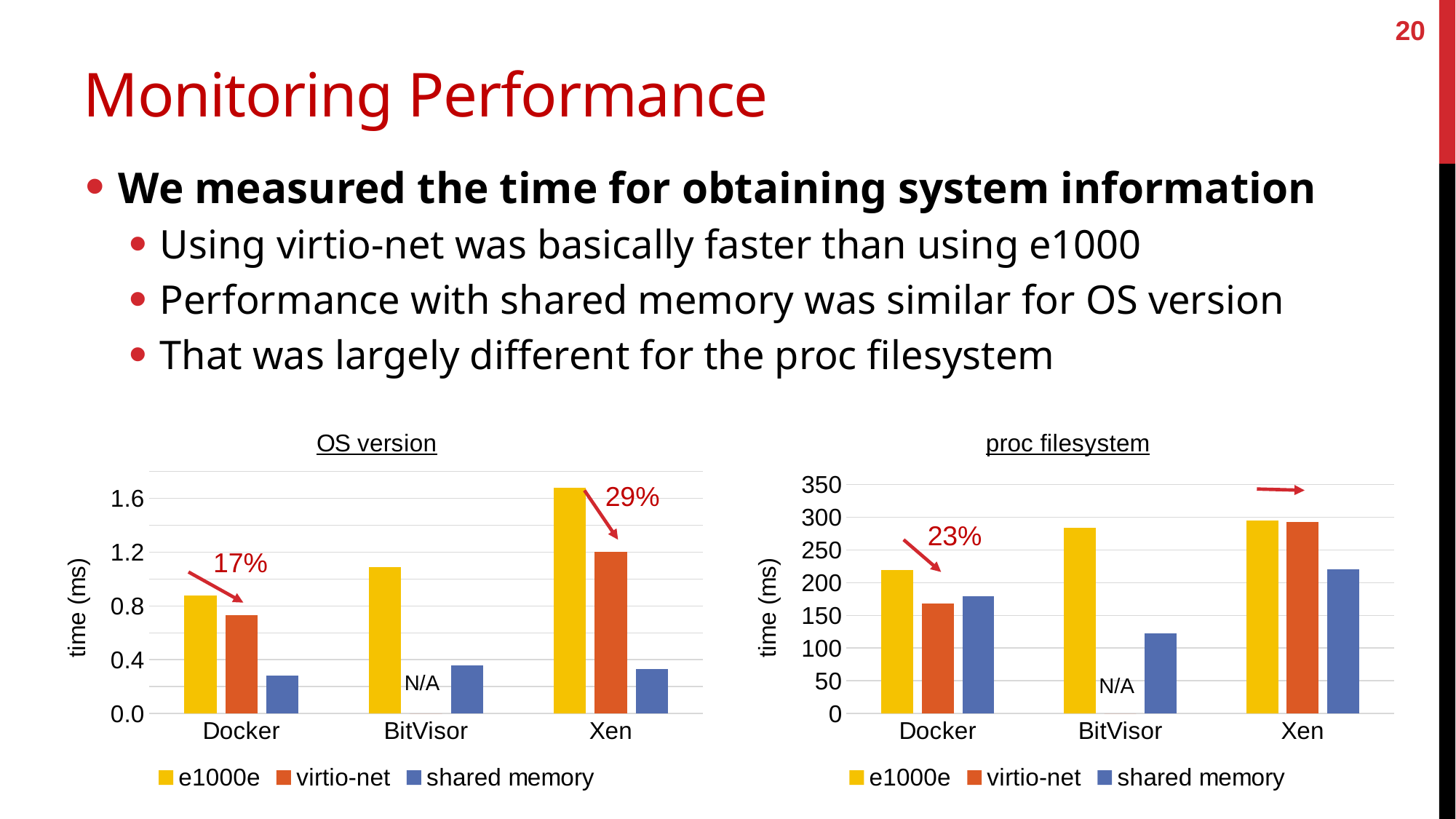
In the "OS version" chart, which category is marked N/A for virtio-net? BitVisor How many series does the legend of the "proc filesystem" chart list? 3 In the "proc filesystem" chart, is the e1000e value for Docker greater or less than 200? greater How many categories are shown on the x axis of the "OS version" chart? 3 In the "OS version" chart, what percentage is annotated above the Docker bars? 17% In the "proc filesystem" chart, is the shared memory value for BitVisor greater or less than 150? less In the "OS version" chart, is the e1000e value for Xen greater or less than 1.6? greater In the "OS version" chart, which category has the highest e1000e bar? Xen In the "proc filesystem" chart, which is larger for Docker: e1000e or virtio-net? e1000e In the "proc filesystem" chart, which category has the lowest shared memory bar? BitVisor What kind of chart is the "OS version" chart? bar chart In the "proc filesystem" chart, which category has the highest shared memory bar? Xen